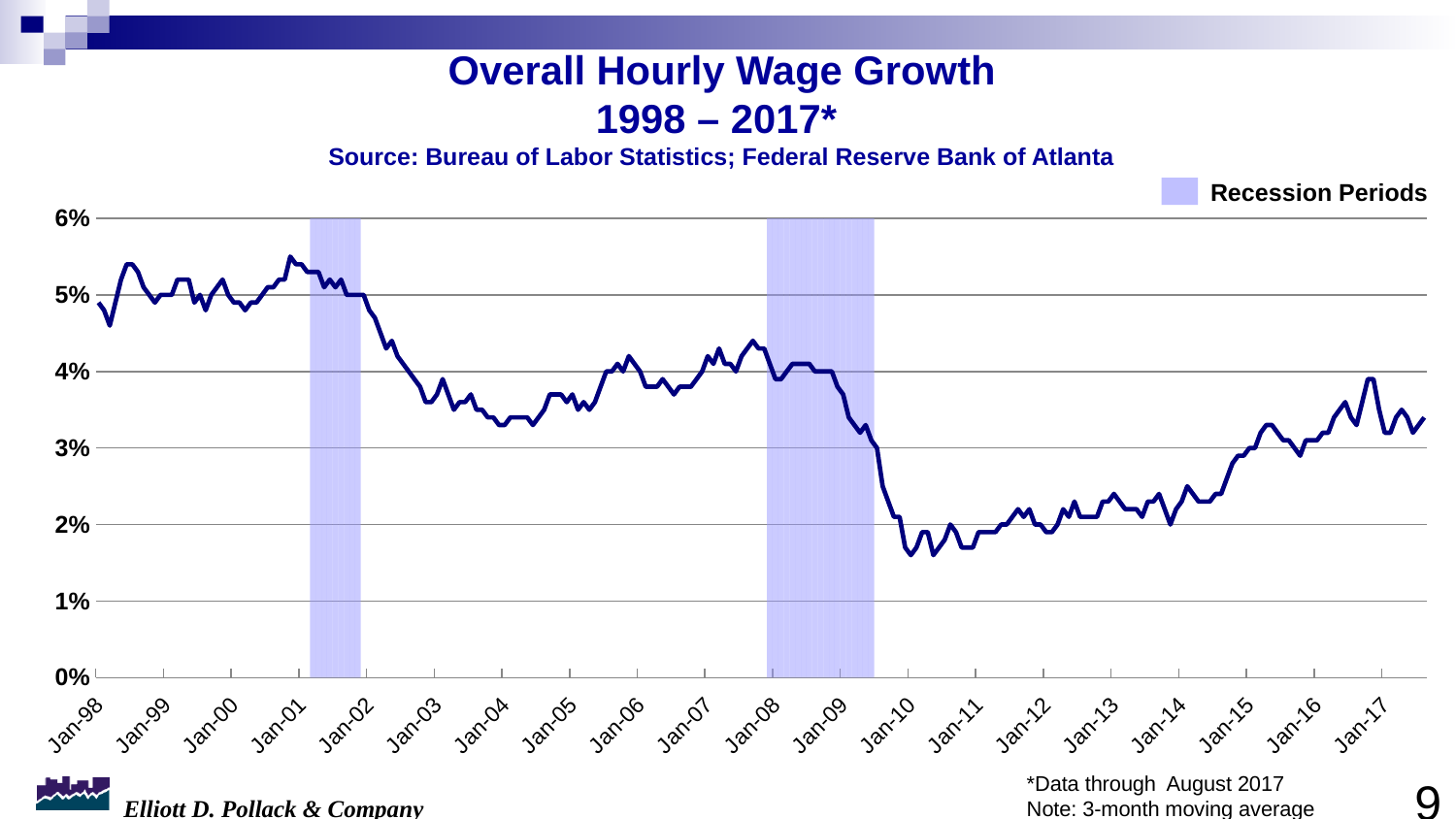
Is the value at Jan-08 greater or less than 3%? greater Is the value at Jan-04 greater or less than 4%? less Is the value at Jan-10 greater or less than 3%? less Does the line generally rise or fall between Jan-01 and Jan-04? fall What is the title of the chart? Overall Hourly Wage Growth 1998 – 2017* Which is larger, the value at Jan-98 or the value at Jan-10? Jan-98 What do the shaded vertical bands on the chart represent, according to the legend? Recession Periods Does the line generally rise or fall between Jan-10 and Jan-17? rise How many date labels are shown along the x axis? 20 What kind of chart is shown on the slide? line chart